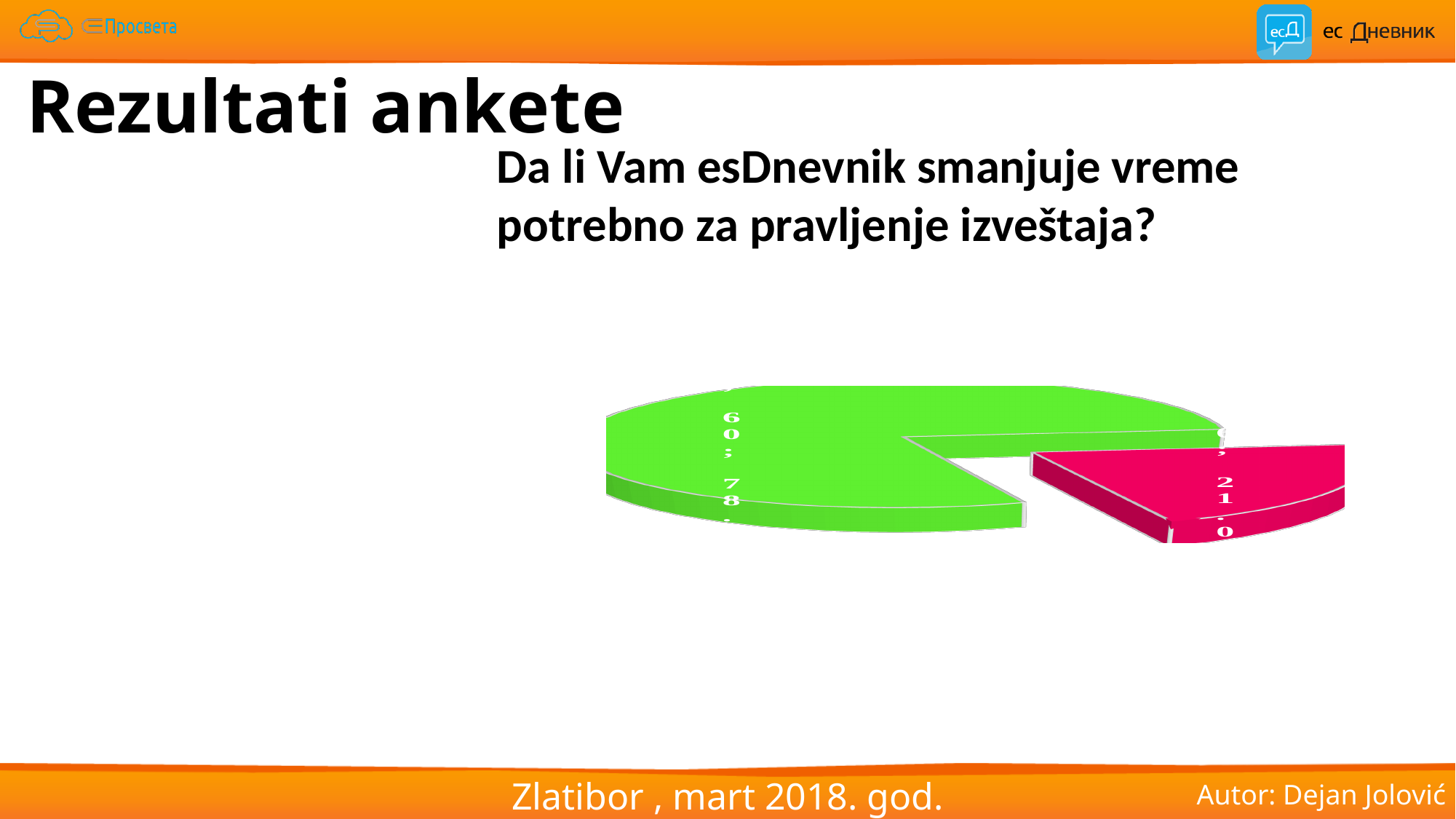
Which slice of the pie chart is larger, the green one or the pink one? the green one Which slice of the pie chart is the largest? the green slice How many slices does the pie chart have? 2 Which slice of the pie chart is pulled out (exploded) from the rest of the pie? the pink slice Which slice of the pie chart is the smallest? the pink slice What question is the pie chart titled with? Da li Vam esDnevnik smanjuje vreme potrebno za pravljenje izveštaja? What kind of chart is shown on the slide? pie chart